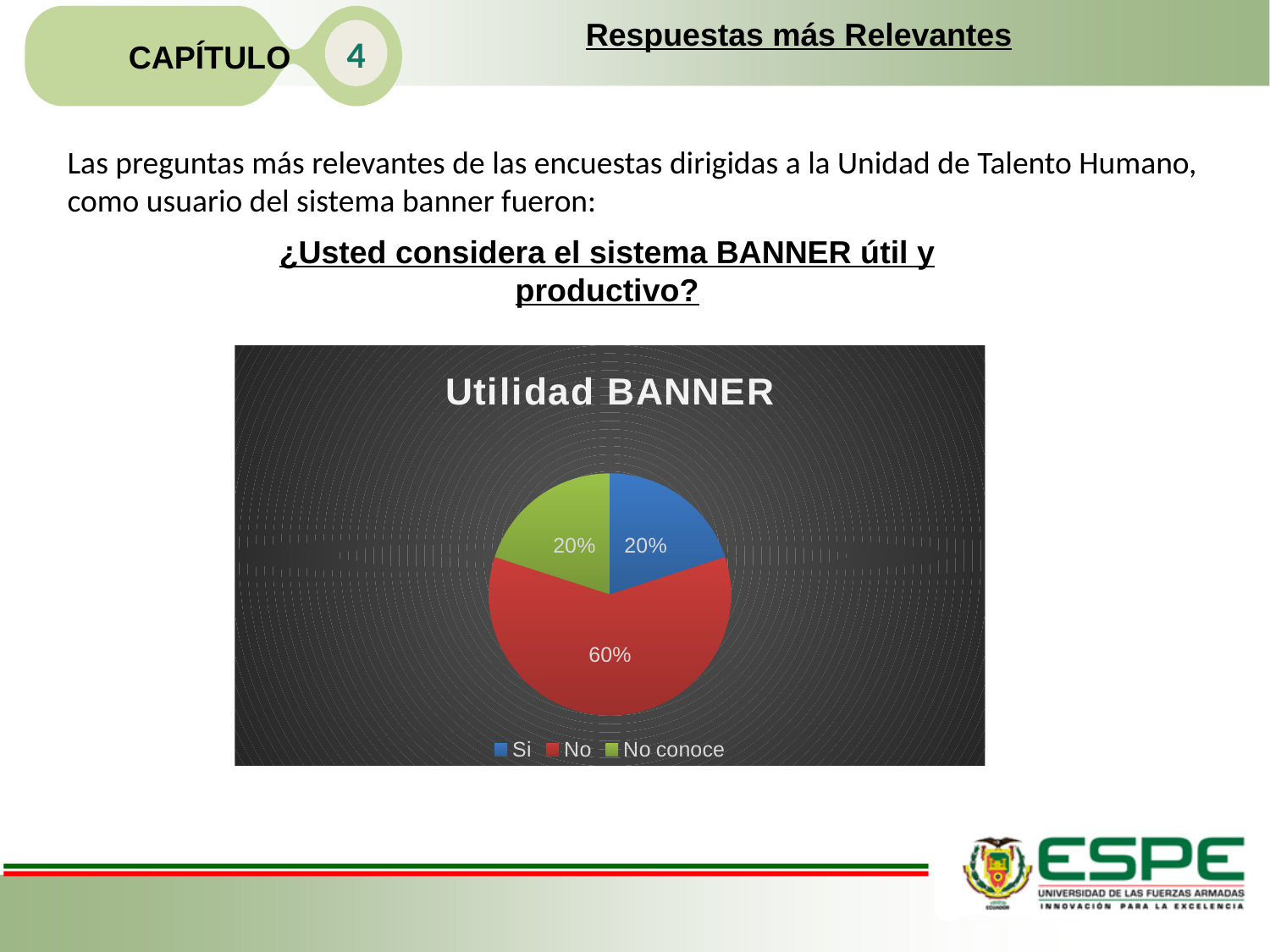
Which category has the largest slice of the pie? No What share of the pie does the "Si" slice represent? 20% What kind of chart is shown on the slide? pie chart What share of the pie does the "No conoce" slice represent? 20% What is the title of the chart? Utilidad BANNER How many slices does the pie chart have? 3 What is the difference between the share for "No" and the share for "Si"? 40% Which is larger, the share for "No" or the share for "No conoce"? No Which colour represents "No" in the pie chart? red How many entries does the legend list? 3 What share of the pie does the "No" slice represent? 60%